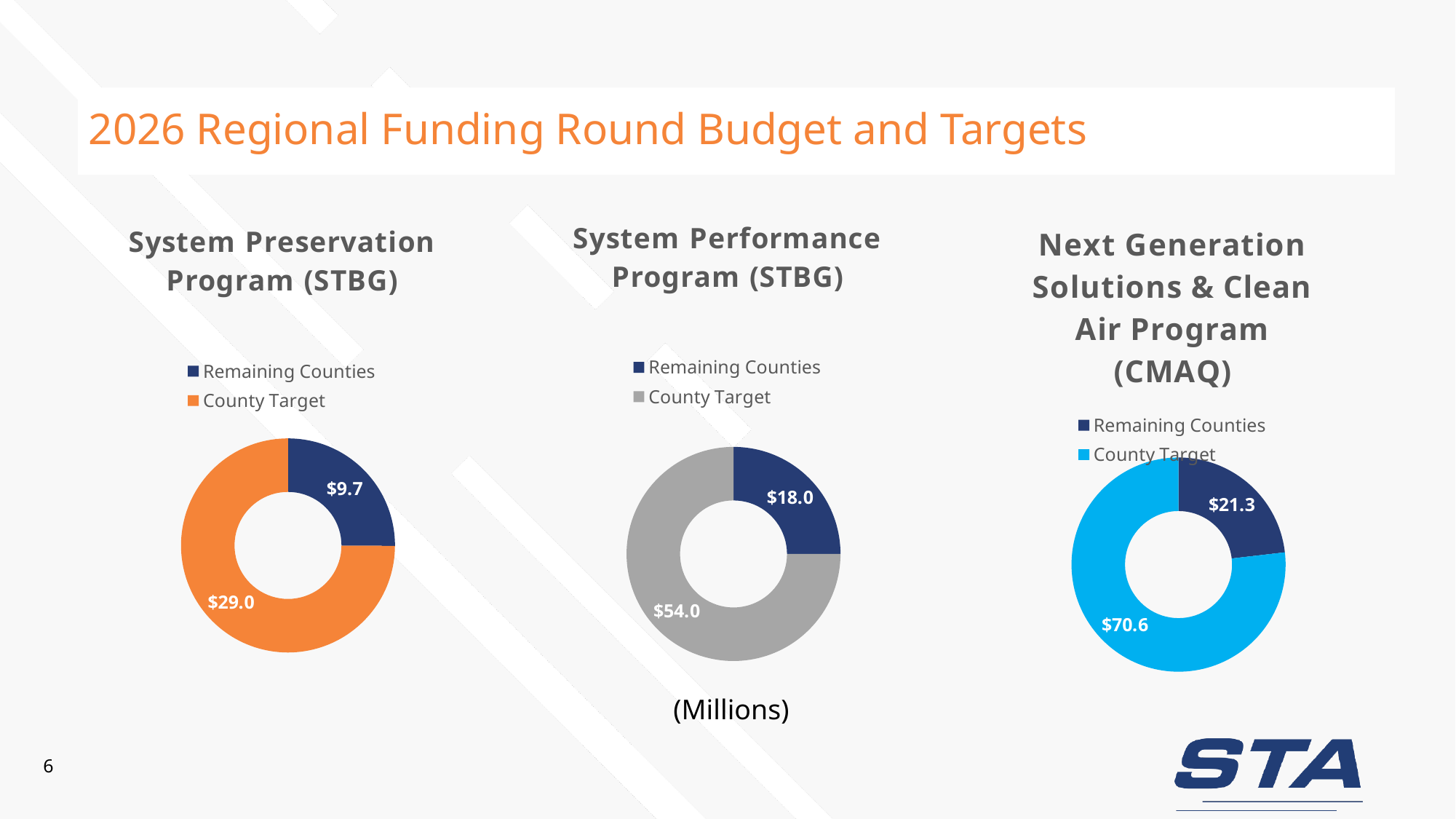
In the Next Generation Solutions & Clean Air Program (CMAQ) chart, what is the value for Remaining Counties? $21.3 In the System Preservation Program (STBG) chart, what is the value for Remaining Counties? $9.7 In the System Performance Program (STBG) chart, what share of the total does Remaining Counties represent? 25% In the System Preservation Program (STBG) chart, what is the difference between County Target and Remaining Counties? $19.3 In the System Performance Program (STBG) chart, what is the value for County Target? $54.0 What kind of chart is used for the System Preservation Program (STBG)? Donut (pie) chart In the Next Generation Solutions & Clean Air Program (CMAQ) chart, what is the value for County Target? $70.6 How many series does the legend of the Next Generation Solutions & Clean Air Program (CMAQ) chart list? 2 In the System Performance Program (STBG) chart, what is the total of the two slices? $72.0 In the System Performance Program (STBG) chart, which slice is larger, Remaining Counties or County Target? County Target In the System Preservation Program (STBG) chart, what is the value for County Target? $29.0 In the Next Generation Solutions & Clean Air Program (CMAQ) chart, what is the difference between County Target and Remaining Counties? $49.3